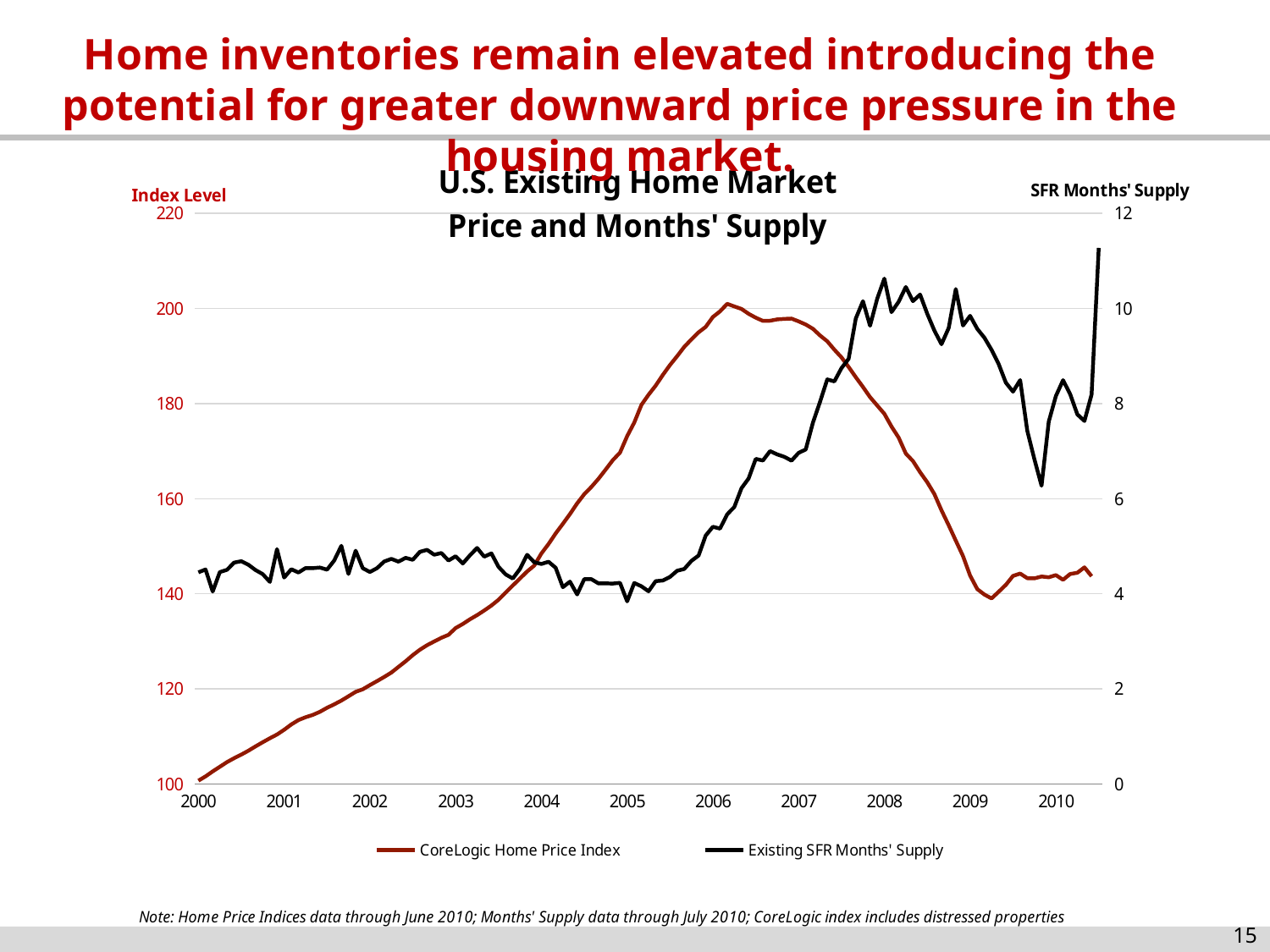
Which series is plotted against the right-hand axis labelled SFR Months' Supply? Existing SFR Months' Supply How many series does the legend list? 2 Does the CoreLogic Home Price Index rise or fall between 2006 and 2009? fall How many year labels are shown on the x axis? 11 Is the value of the CoreLogic Home Price Index at its 2006 peak greater or less than 180? greater Is the value of Existing SFR Months' Supply in 2005 greater or less than 6? less What is the title of the chart? U.S. Existing Home Market Price and Months' Supply Is the value of Existing SFR Months' Supply at the start of 2008 greater or less than 8? greater What kind of chart is shown on the slide? line chart Does the CoreLogic Home Price Index rise or fall between 2000 and 2006? rise